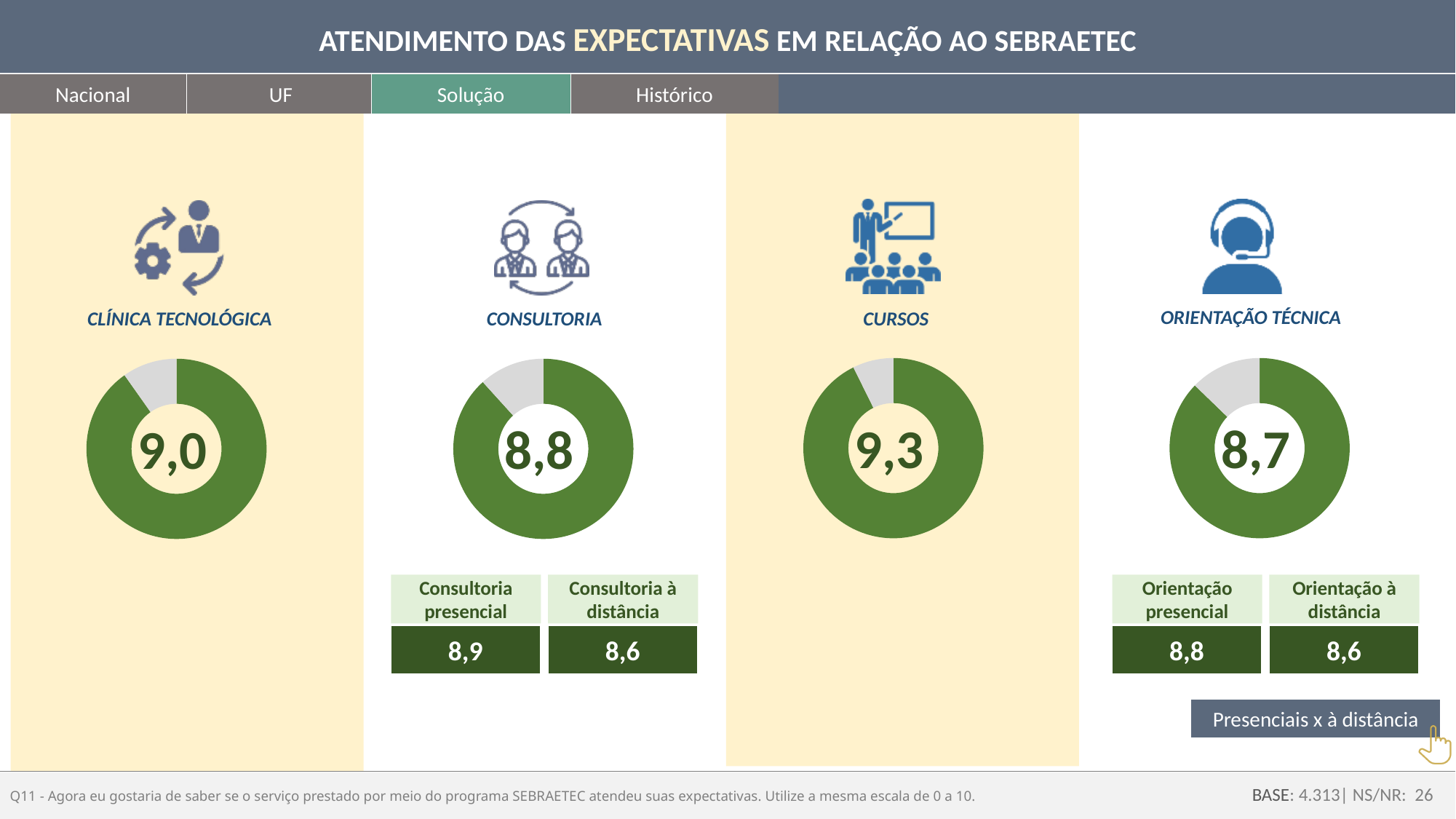
Which of the four solutions (Clínica Tecnológica, Consultoria, Cursos, Orientação Técnica) has the lowest score? Orientação Técnica What is the difference between the CURSOS score and the ORIENTAÇÃO TÉCNICA score? 0,6 What value is shown in the centre of the CURSOS donut chart? 9,3 Under the ORIENTAÇÃO TÉCNICA chart, what is the score for Orientação à distância? 8,6 Under the CONSULTORIA chart, what is the score for Consultoria presencial? 8,9 What value is shown in the centre of the CLÍNICA TECNOLÓGICA donut chart? 9,0 What value is shown in the centre of the ORIENTAÇÃO TÉCNICA donut chart? 8,7 What kind of chart is used to display each solution's score on the slide? Donut chart How many donut charts are shown on the slide? 4 What value is shown in the centre of the CONSULTORIA donut chart? 8,8 Which has a higher score, CLÍNICA TECNOLÓGICA or CONSULTORIA? Clínica Tecnológica Which of the four solutions (Clínica Tecnológica, Consultoria, Cursos, Orientação Técnica) has the highest score? Cursos